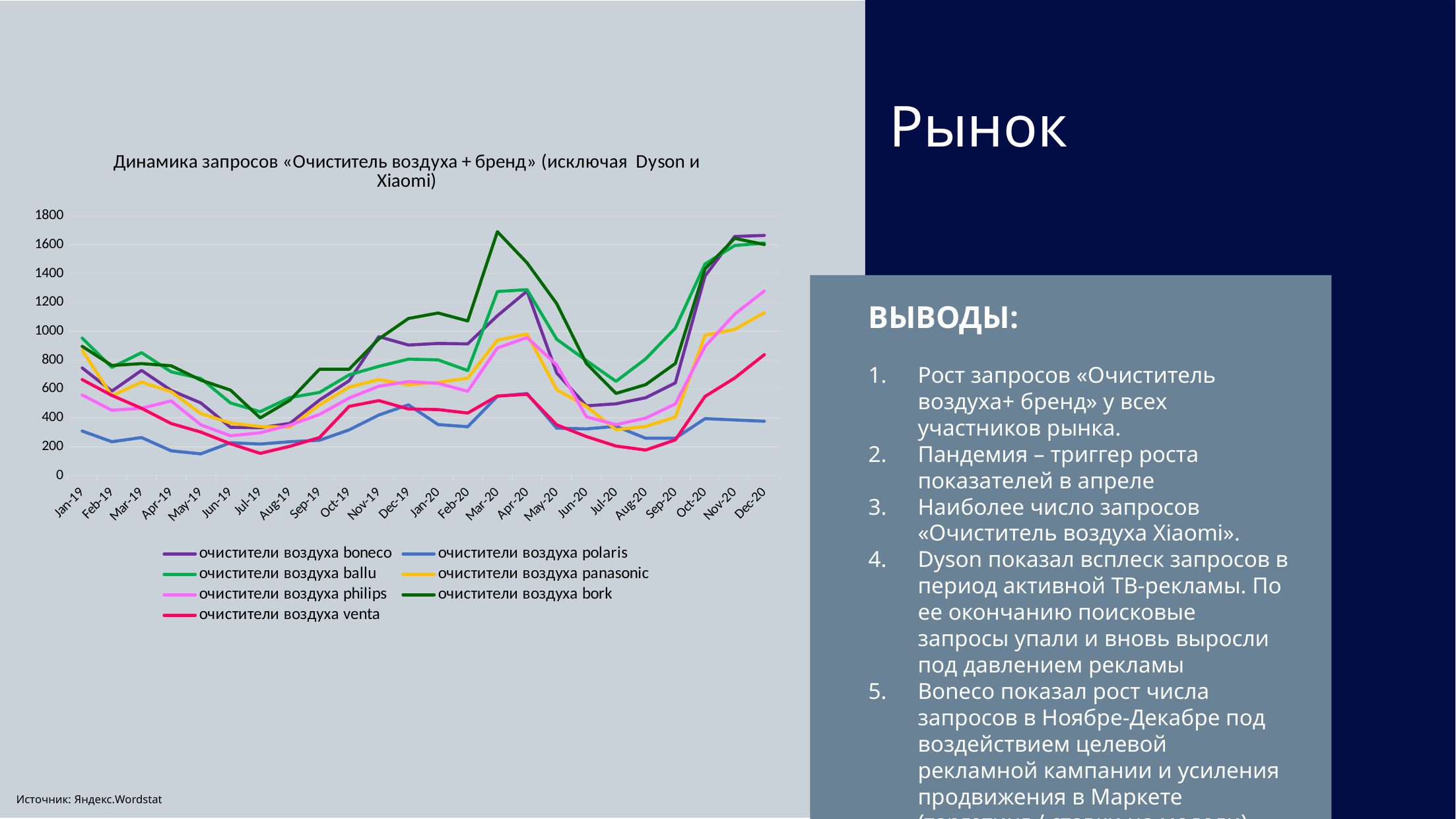
Does the value for очистители воздуха bork rise or fall from Mar-20 to Jul-20? fall Which series has the lowest value in Dec-20? очистители воздуха polaris Is the value for очистители воздуха panasonic in Dec-20 greater or less than 1000? greater Which series has the highest value in Mar-20? очистители воздуха bork Is the value for очистители воздуха polaris in Jan-19 greater or less than 400? less Is the value for очистители воздуха bork in Mar-20 greater or less than 1600? greater In Mar-20, which is larger: the value for очистители воздуха bork or очистители воздуха polaris? очистители воздуха bork How many series does the legend list? 7 What source is cited for the chart data? Яндекс.Wordstat What kind of chart is shown on the slide? line chart How many months are shown along the x axis? 24